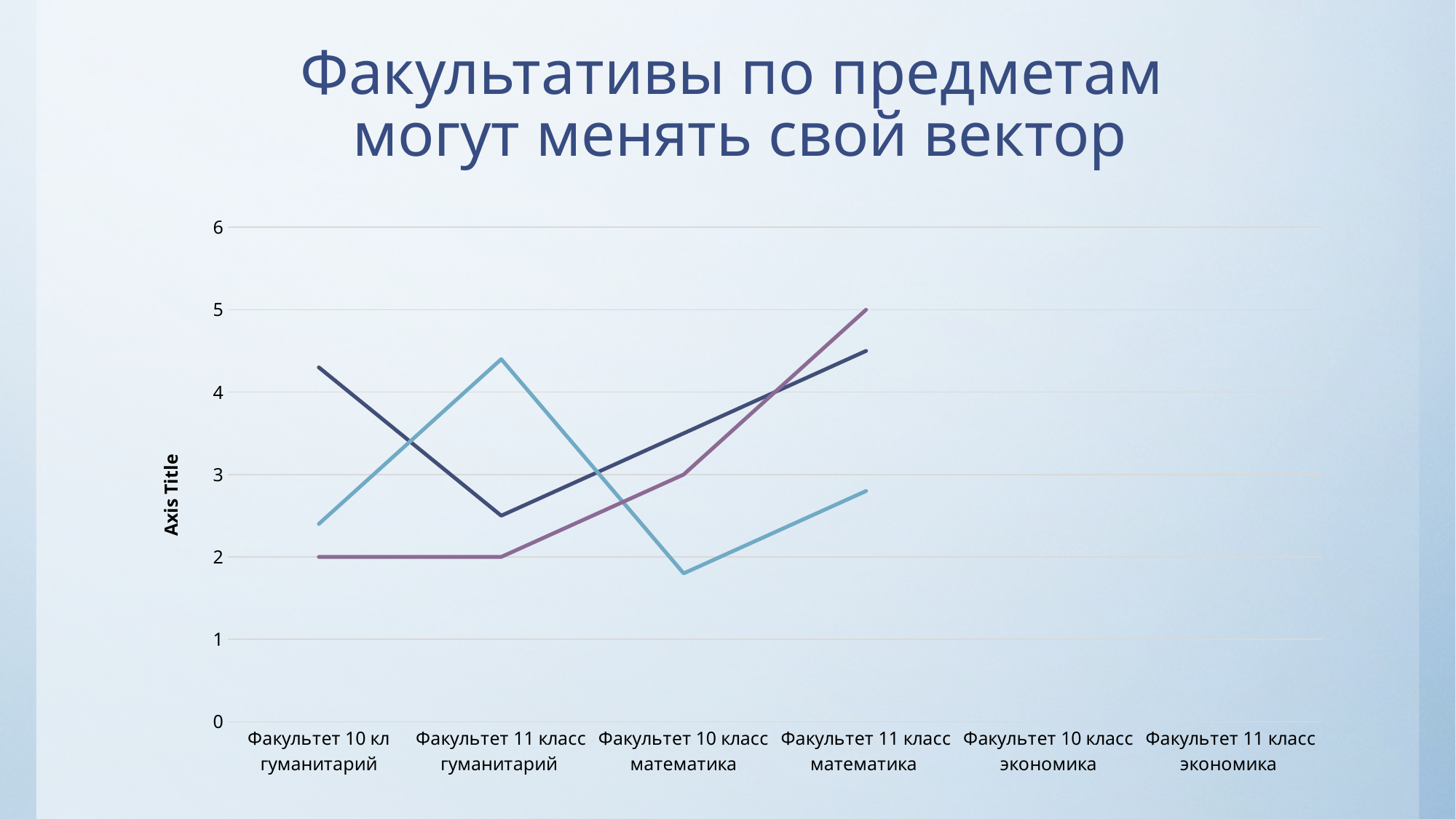
Is the value of the light blue line at "Факультет 10 класс математика" greater or less than 2? less What is the title shown on the vertical axis of the chart? Axis Title At "Факультет 11 класс гуманитарий", which line has the larger value, the light blue line or the dark blue line? the light blue line At which category does the purple line reach its highest value? Факультет 11 класс математика What kind of chart is shown on the slide? line chart What is the value of the purple line at "Факультет 10 кл гуманитарий"? 2 How many lines are plotted on the chart? 3 Does the purple line rise or fall from "Факультет 11 класс гуманитарий" to "Факультет 11 класс математика"? rises How many categories are listed along the x axis of the chart? 6 What is the value of the purple line at "Факультет 10 класс математика"? 3 What is the value of the purple line at "Факультет 11 класс математика"? 5 Is the value of the dark blue line at "Факультет 10 кл гуманитарий" greater or less than 4? greater